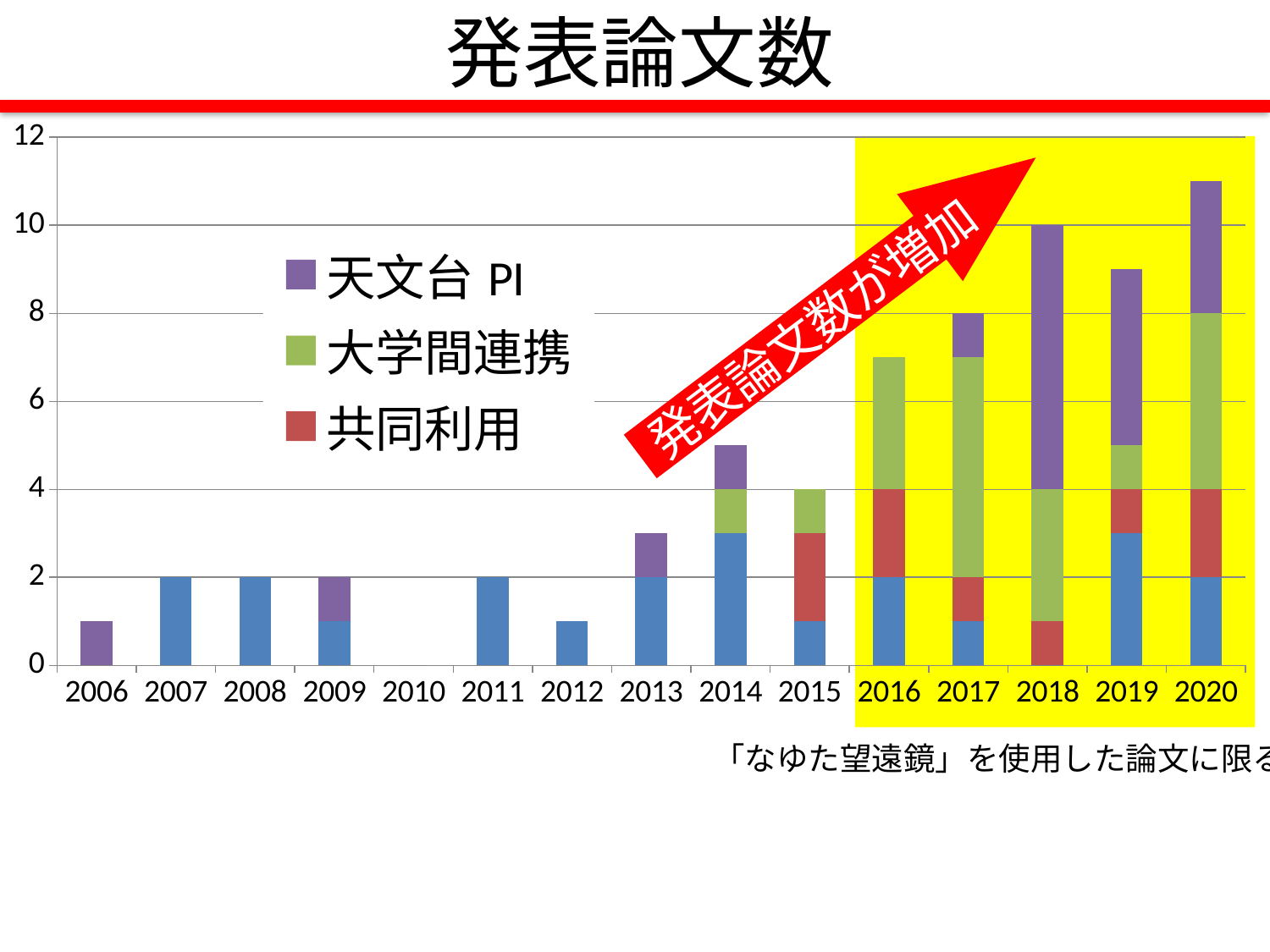
Is the total for 2013 greater or less than 4? less How many years are shown on the x axis? 15 Which legend entry is shown in purple? 天文台 PI Is the total for 2020 greater or less than 10? greater Which year has the taller bar, 2014 or 2015? 2014 Which year has no bar at all (the lowest value)? 2010 What is the total height of the stacked bar for 2017? 8 What kind of chart is shown on the slide? stacked bar chart Which year has the tallest bar? 2020 What is the total height of the stacked bar for 2015? 4 How many series does the legend list? 3 What is the total height of the stacked bar for 2018? 10